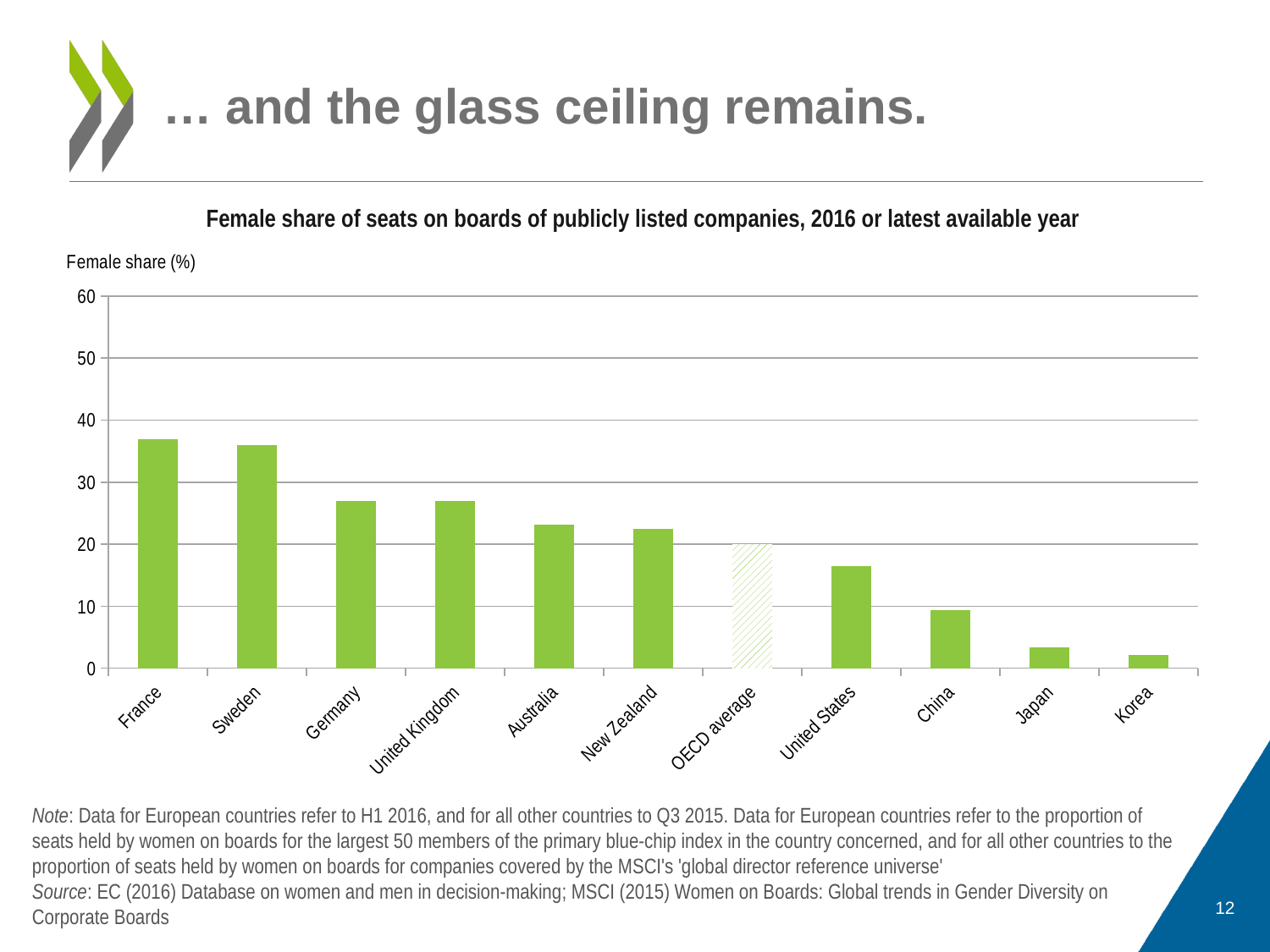
Is the value for Australia greater or less than 20? greater What kind of chart is shown on the slide? bar chart Is the value for France greater or less than 30? greater Do the values generally rise or fall moving from left to right along the x axis? fall Is the value for the United States greater or less than 20? less Which has a higher female share of board seats, France or the United States? France Which has a higher female share of board seats, Germany or China? Germany How many countries or groups are shown on the x axis of the chart? 11 Which bar in the chart is drawn with a hatched pattern rather than solid fill? OECD average Which category has the lowest female share of board seats? Korea